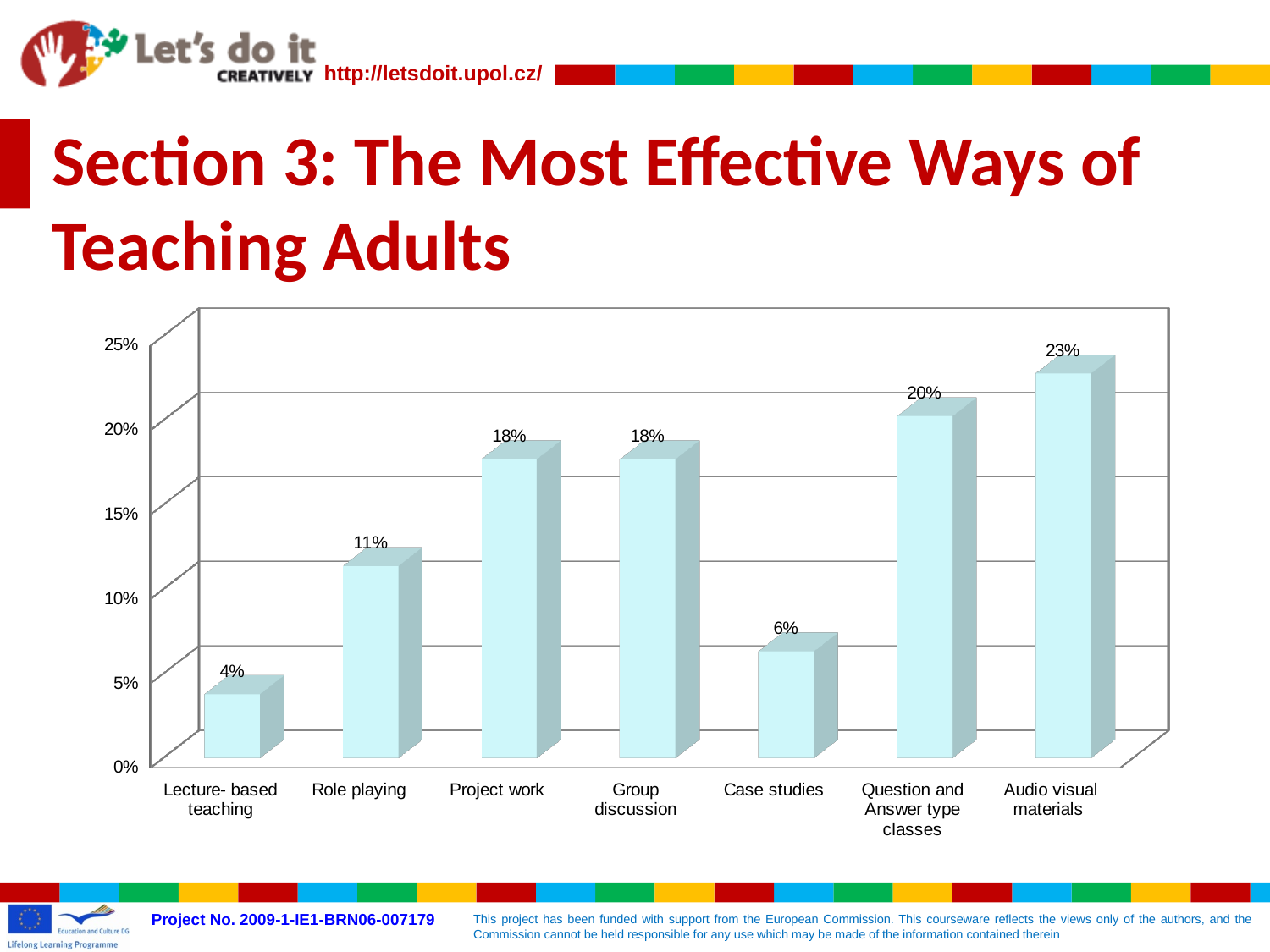
What kind of chart is shown on the slide? bar chart What is the difference between the values for Role playing and Lecture- based teaching? 7% Which category has the lowest value? Lecture- based teaching What is the value for Audio visual materials? 23% What is the difference between the values for Audio visual materials and Question and Answer type classes? 3% How many categories are shown on the x axis? 7 What is the value for Lecture- based teaching? 4% Is the value for Group discussion greater or less than 15%? greater Which category has the highest value? Audio visual materials What is the value for Role playing? 11% What is the value for Case studies? 6% Which is larger, the value for Question and Answer type classes or the value for Project work? Question and Answer type classes